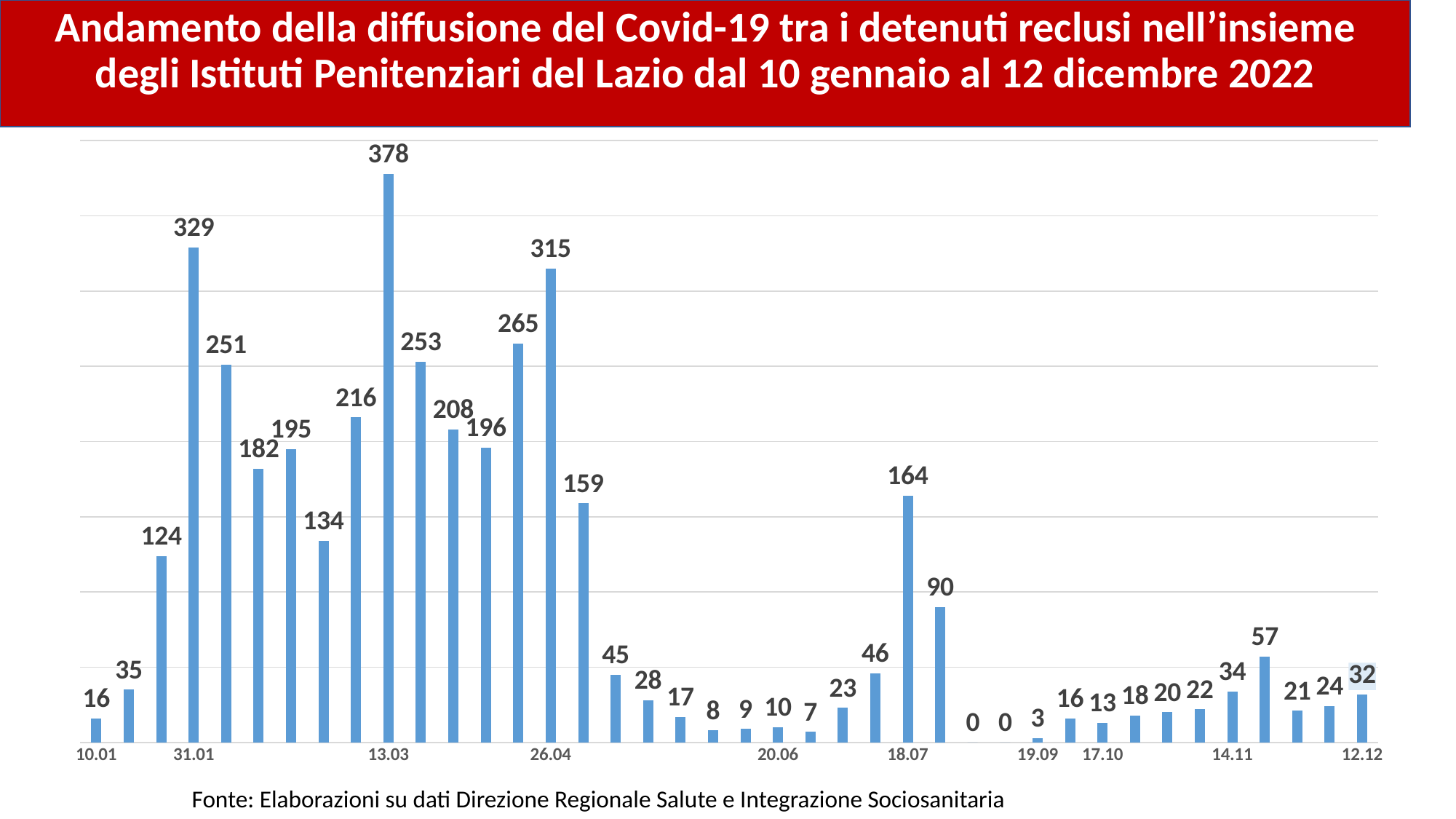
What value is shown for 12.12? 32 What kind of chart is shown on the slide? Bar chart What value is shown for 26.04? 315 What value is shown for 10.01? 16 How many bars are plotted on the chart? 40 Which date has the highest value? 13.03 What value is shown for 18.07? 164 What value is shown for 13.03? 378 What is the difference between the values for 13.03 and 31.01? 49 What is the lowest value shown on the chart? 0 What value is shown for 31.01? 329 Which is larger, the value for 31.01 or the value for 26.04? 31.01